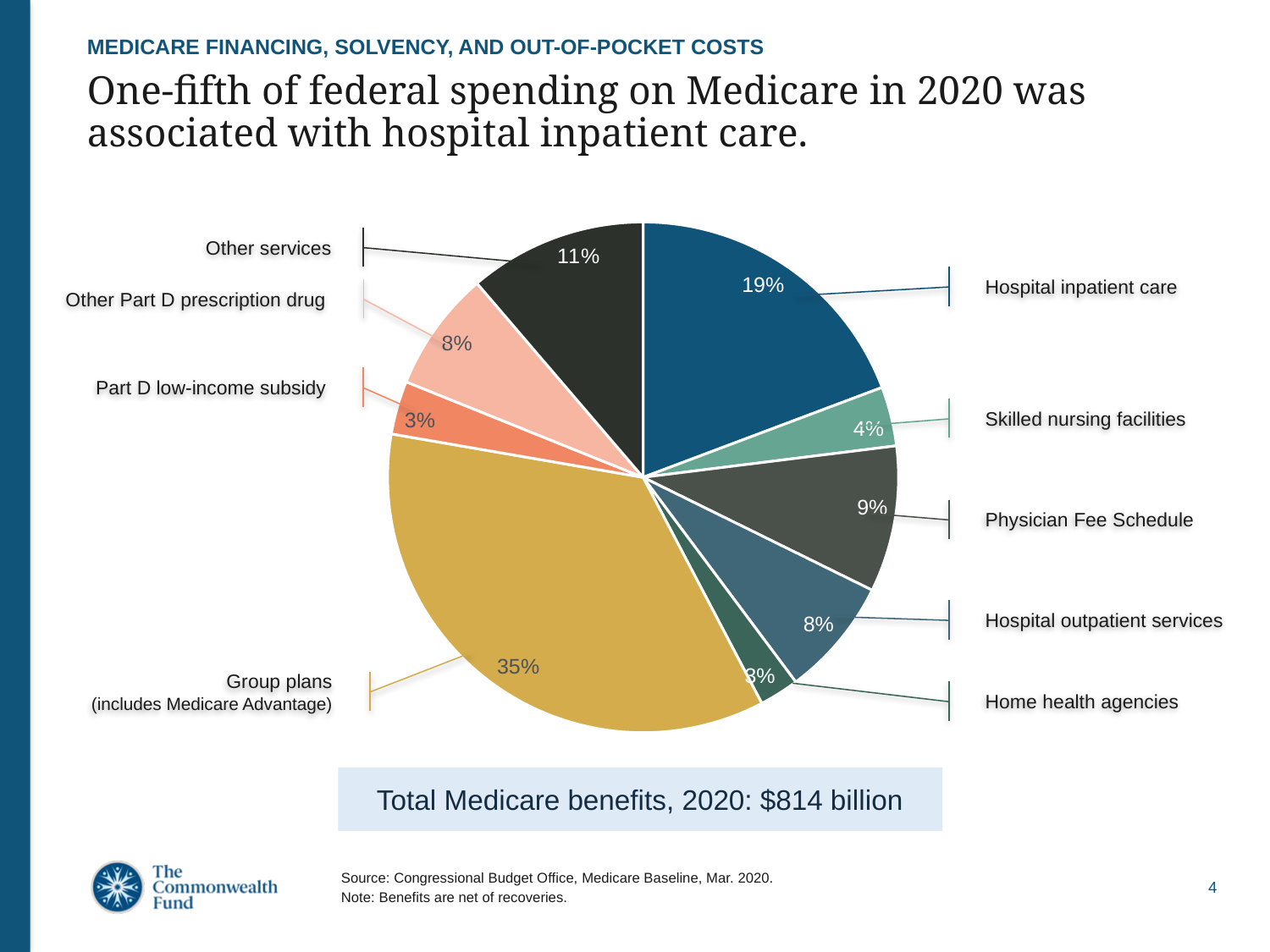
Which category is larger: Hospital inpatient care or Other services? Hospital inpatient care What is the total Medicare benefits figure for 2020 stated below the chart? $814 billion What share of Medicare benefits in 2020 went to hospital inpatient care? 19% What is the difference in percentage points between Physician Fee Schedule and Home health agencies? 6 What type of chart is shown on the slide? Pie chart What is the difference in percentage points between Group plans and Hospital inpatient care? 16 How many categories are shown in the pie chart? 9 What percentage is labeled for Skilled nursing facilities? 4% What share is shown for Physician Fee Schedule? 9% What percentage of the pie is Group plans (includes Medicare Advantage)? 35% Which category has the largest slice of the pie? Group plans (includes Medicare Advantage) What share of the pie is Other Part D prescription drug? 8%